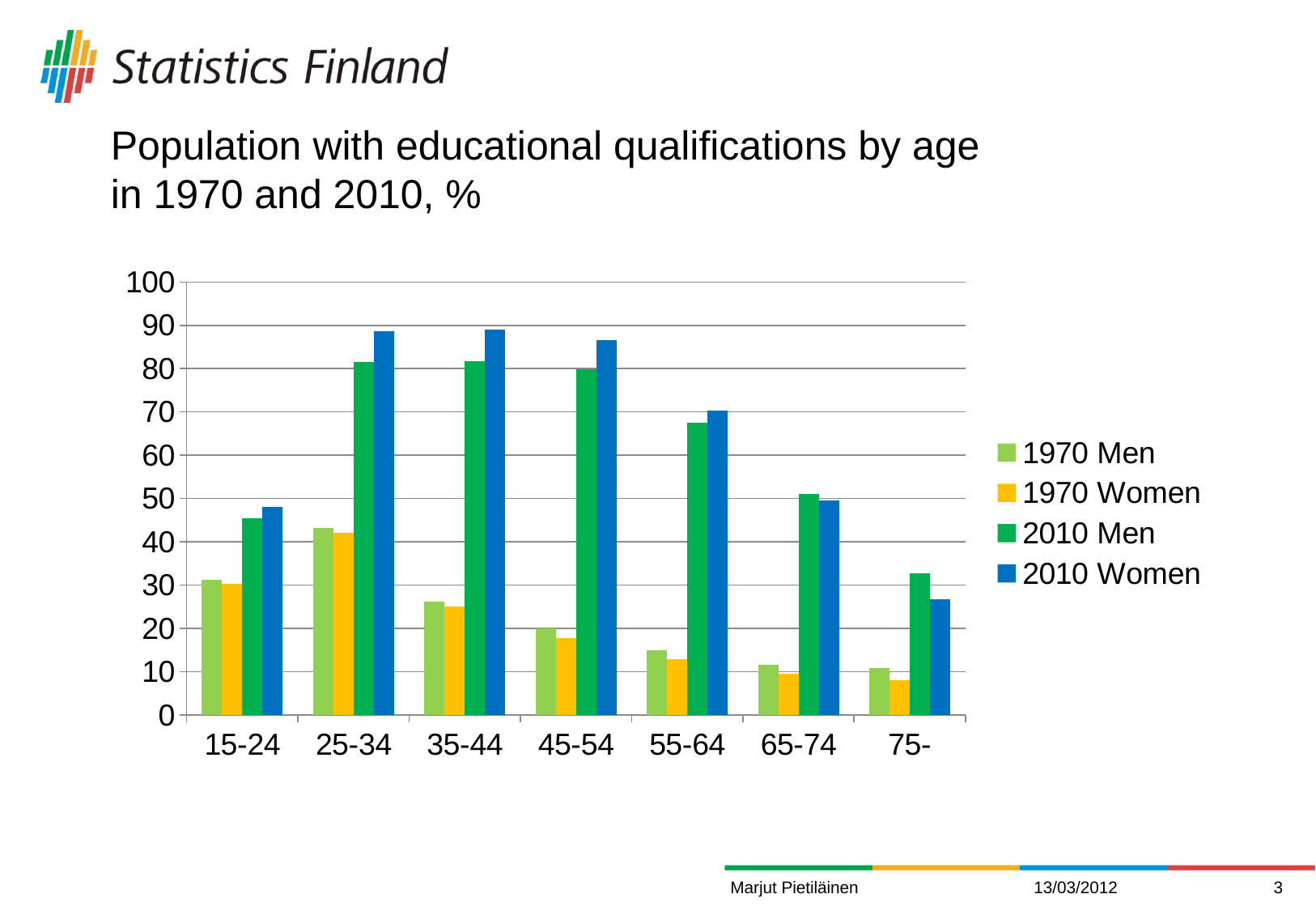
How many series does the legend list? 4 Which age group has the lowest value for 2010 Men? 75- What kind of chart is shown on the slide? bar chart In the 75- age group, which is larger: 2010 Men or 2010 Women? 2010 Men Is the value for 2010 Men in the 55-64 age group greater or less than 70? less How many age groups are shown on the x axis? 7 Is the value for 2010 Women in the 25-34 age group greater or less than 80? greater Which age group has the lowest value for 2010 Women? 75- In the 25-34 age group, which is larger: 2010 Men or 2010 Women? 2010 Women Which age group has the highest value for 1970 Men? 25-34 Do the values for 1970 Men rise or fall from the 25-34 age group to the 75- age group? fall Is the value for 1970 Women in the 75- age group greater or less than 10? less